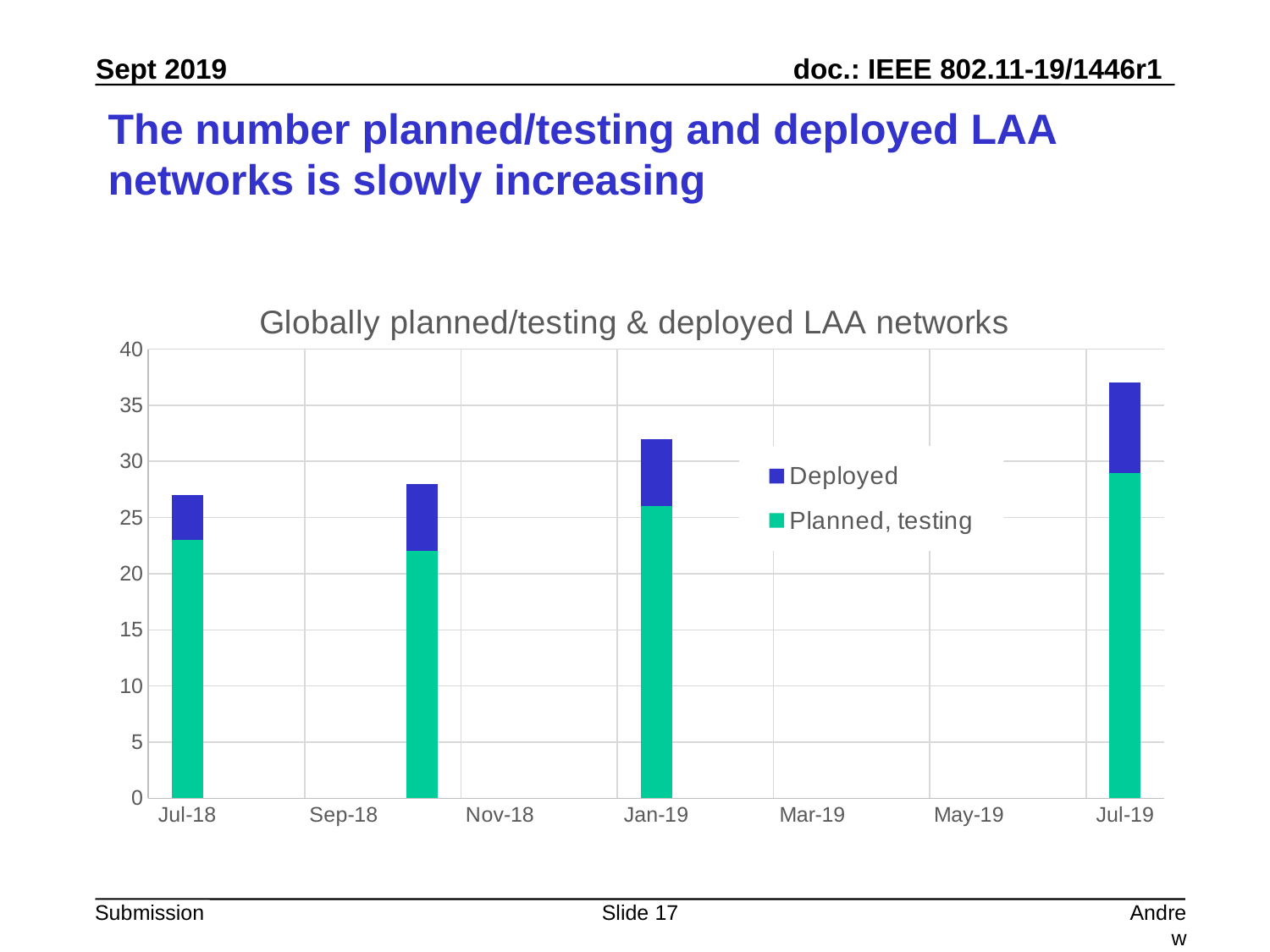
What kind of chart is shown on the slide? Stacked bar chart Which is larger, the total bar for Jan-19 or the total bar for Jul-18? Jan-19 Is the total bar height for Jul-19 greater or less than 35? greater Which series is shown in green in the chart? Planned, testing Is the Planned, testing value for Jul-18 greater or less than 20? greater Is the total bar height for Jan-19 greater or less than 30? greater How many series does the chart legend list? 2 Which date has the tallest stacked bar in the chart? Jul-19 What is the title of the chart? Globally planned/testing & deployed LAA networks Do the total bar heights rise or fall from Jul-18 to Jul-19? Rise How many bars are plotted in the chart? 4